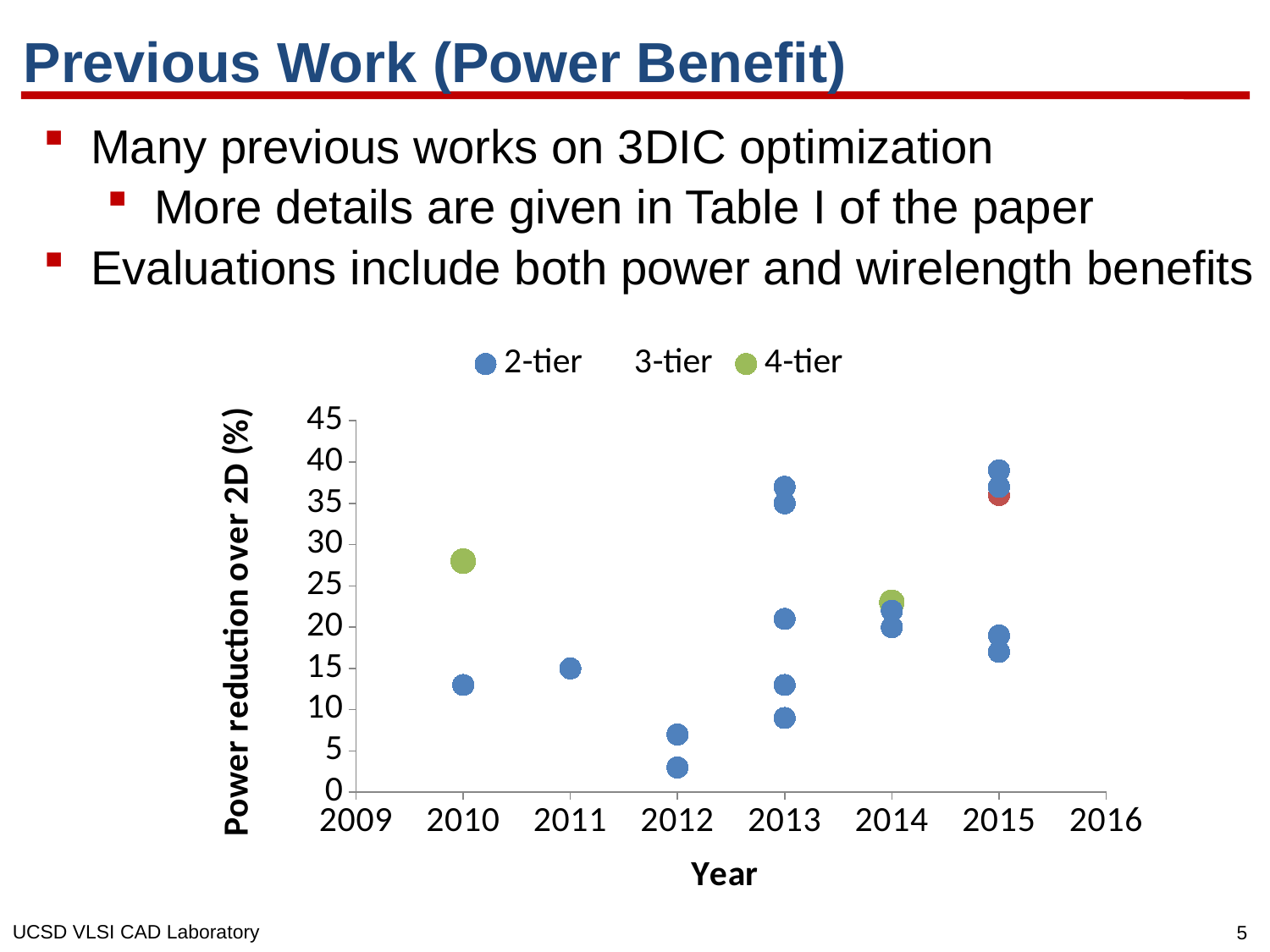
Is the highest point in 2015 greater or less than 35? greater What is the label of the vertical axis? Power reduction over 2D (%) Is the 4-tier point in 2010 greater or less than 25 on the power reduction axis? greater In which year does the lowest power reduction point appear? 2012 Is the lowest point in 2012 greater or less than 5? less Which is larger: the 4-tier point in 2010 or the 2-tier point in 2011? the 4-tier point in 2010 How many series does the legend list? 3 How many 4-tier points are plotted on the chart? 2 What kind of chart is shown on the slide? scatter chart What are the series names listed in the legend? 2-tier, 3-tier, 4-tier